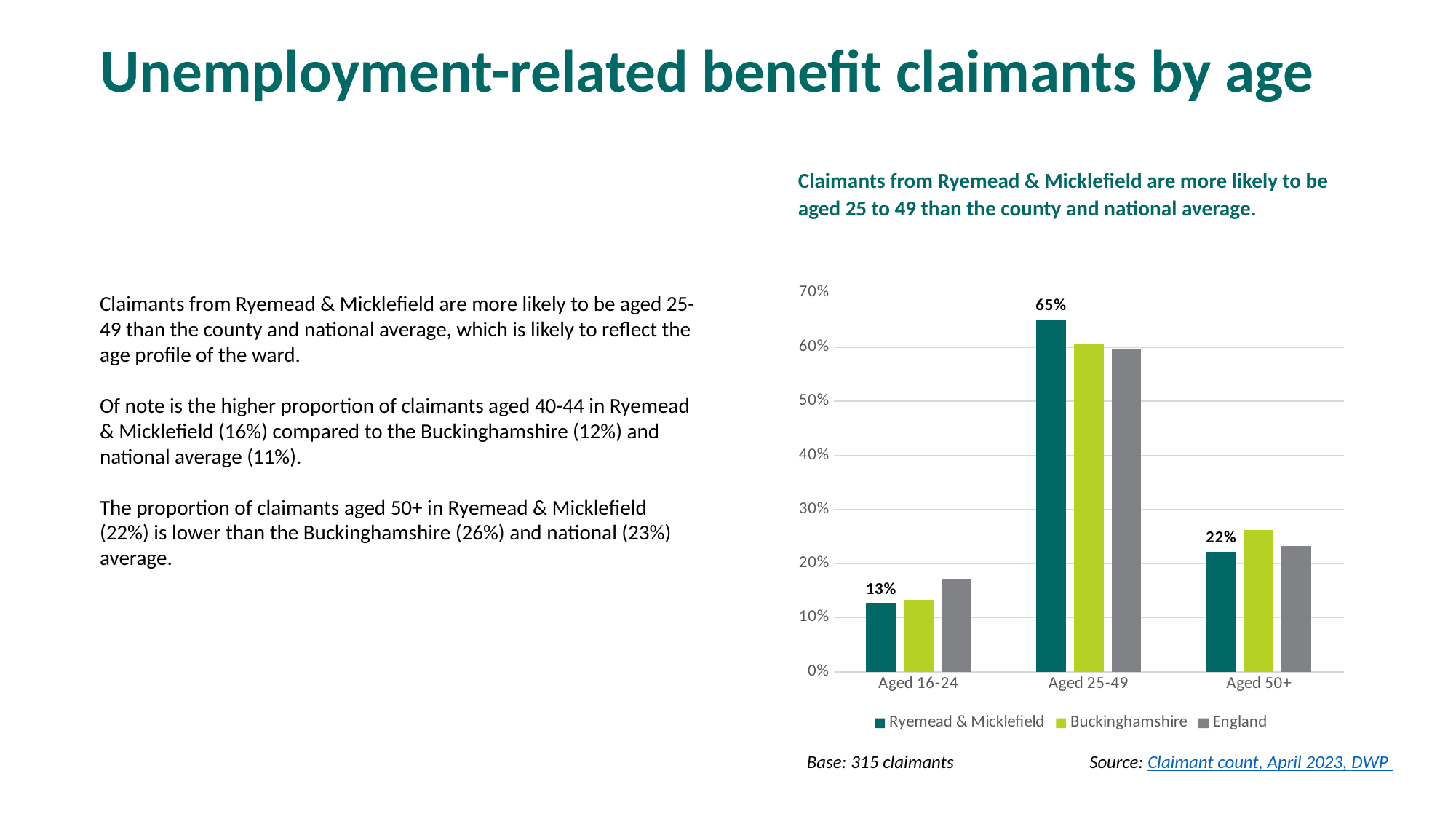
What percentage of Ryemead & Micklefield claimants are aged 25-49? 65% Is the value for England in the Aged 16-24 group greater or less than 20%? less What is the difference between the Ryemead & Micklefield shares for Aged 25-49 and Aged 50+? 43% Which age group has the highest share of Ryemead & Micklefield claimants? Aged 25-49 For Aged 50+, which is larger: the Buckinghamshire bar or the Ryemead & Micklefield bar? Buckinghamshire What kind of chart is shown on the slide? Bar chart What percentage of Ryemead & Micklefield claimants are aged 50+? 22% Is the value for Buckinghamshire in the Aged 50+ group greater or less than 20%? greater What percentage of Ryemead & Micklefield claimants are aged 16-24? 13% How many series does the legend list? 3 Which age group has the lowest share of Ryemead & Micklefield claimants? Aged 16-24 For Aged 16-24, which is larger: the Ryemead & Micklefield bar or the England bar? England